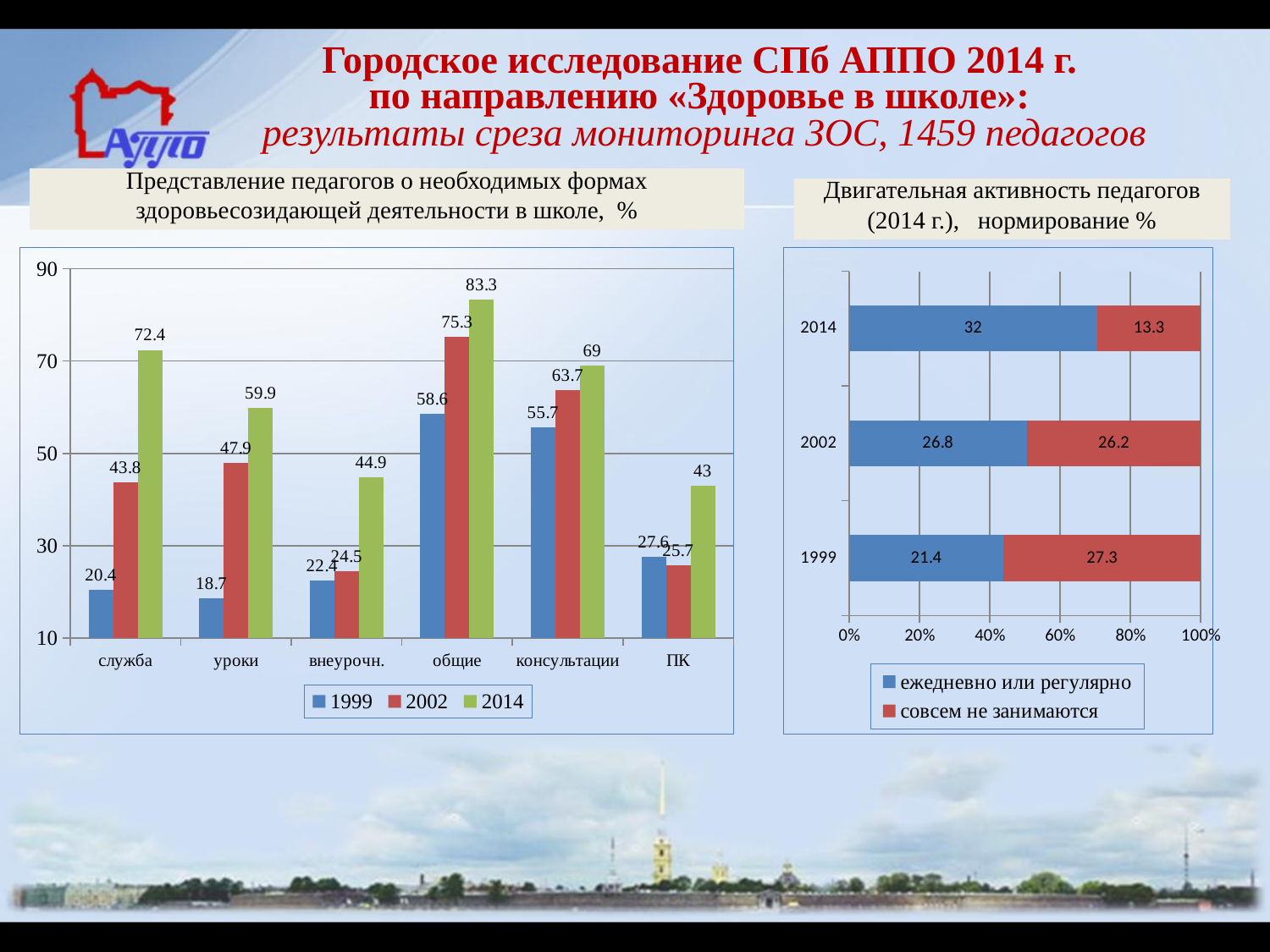
In the right chart, which year has the highest value for ежедневно или регулярно? 2014 In the left chart, which is larger for ПК: the 1999 value or the 2002 value? 1999 In the left chart, which category has the highest value for the 2002 series? общие In the left chart, what is the difference between the 2014 and 1999 values for служба? 52 In the left chart, which category has the lowest value for the 1999 series? уроки In the left chart, how many series does the legend list? 3 What kind of chart is the right chart? stacked bar chart In the left chart, how many categories are shown on the x axis? 6 In the right chart (Двигательная активность педагогов), what is the value for ежедневно или регулярно in 2014? 32 In the left chart, what is the value for служба in 1999? 20.4 In the right chart, what is the value for совсем не занимаются in 1999? 27.3 In the left chart (Представление педагогов о необходимых формах здоровьесозидающей деятельности в школе), what is the value for общие in 2014? 83.3